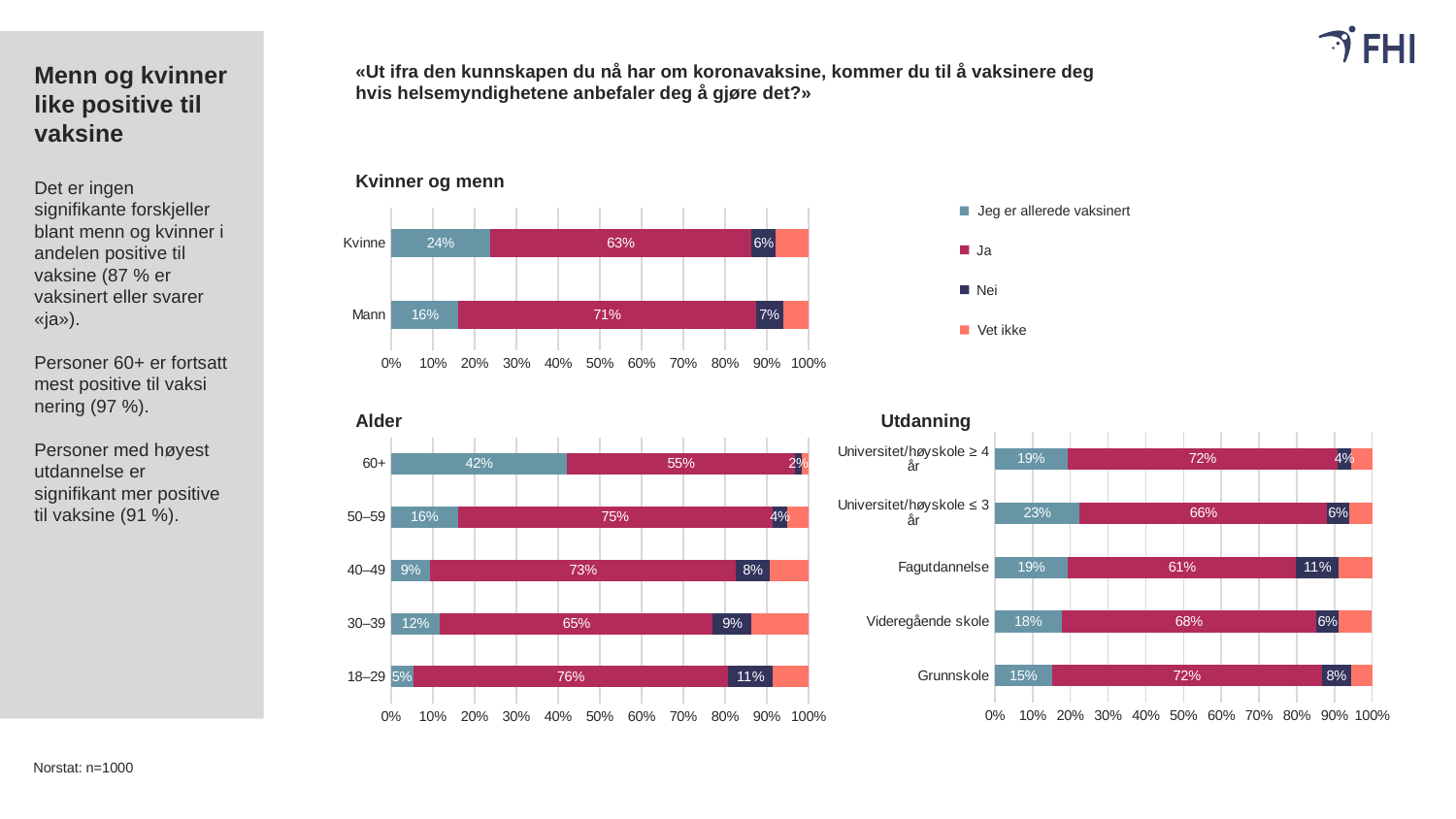
In the 'Utdanning' chart, what is the 'Jeg er allerede vaksinert' value for Universitet/høyskole ≤ 3 år? 23% In the 'Utdanning' chart, which has the larger 'Ja' share: Grunnskole or Fagutdannelse? Grunnskole In the 'Alder' chart, what is the 'Nei' value for the 18–29 group? 11% In the 'Kvinner og menn' chart, how many percentage points higher is the 'Ja' share for Mann than for Kvinne? 8 percentage points In the 'Alder' chart, how many age groups are shown? 5 In the 'Utdanning' chart, which education group has the highest 'Nei' share? Fagutdannelse In the 'Alder' chart, which age group has the lowest 'Ja' share? 60+ In the 'Kvinner og menn' chart, what is the 'Jeg er allerede vaksinert' value for Mann? 16% How many series does the legend on the slide list? 4 In the 'Alder' chart, which age group has the highest 'Jeg er allerede vaksinert' share? 60+ What type of chart is the 'Alder' chart? Stacked bar chart In the 'Kvinner og menn' chart, what percentage of Kvinne answered 'Ja'? 63%